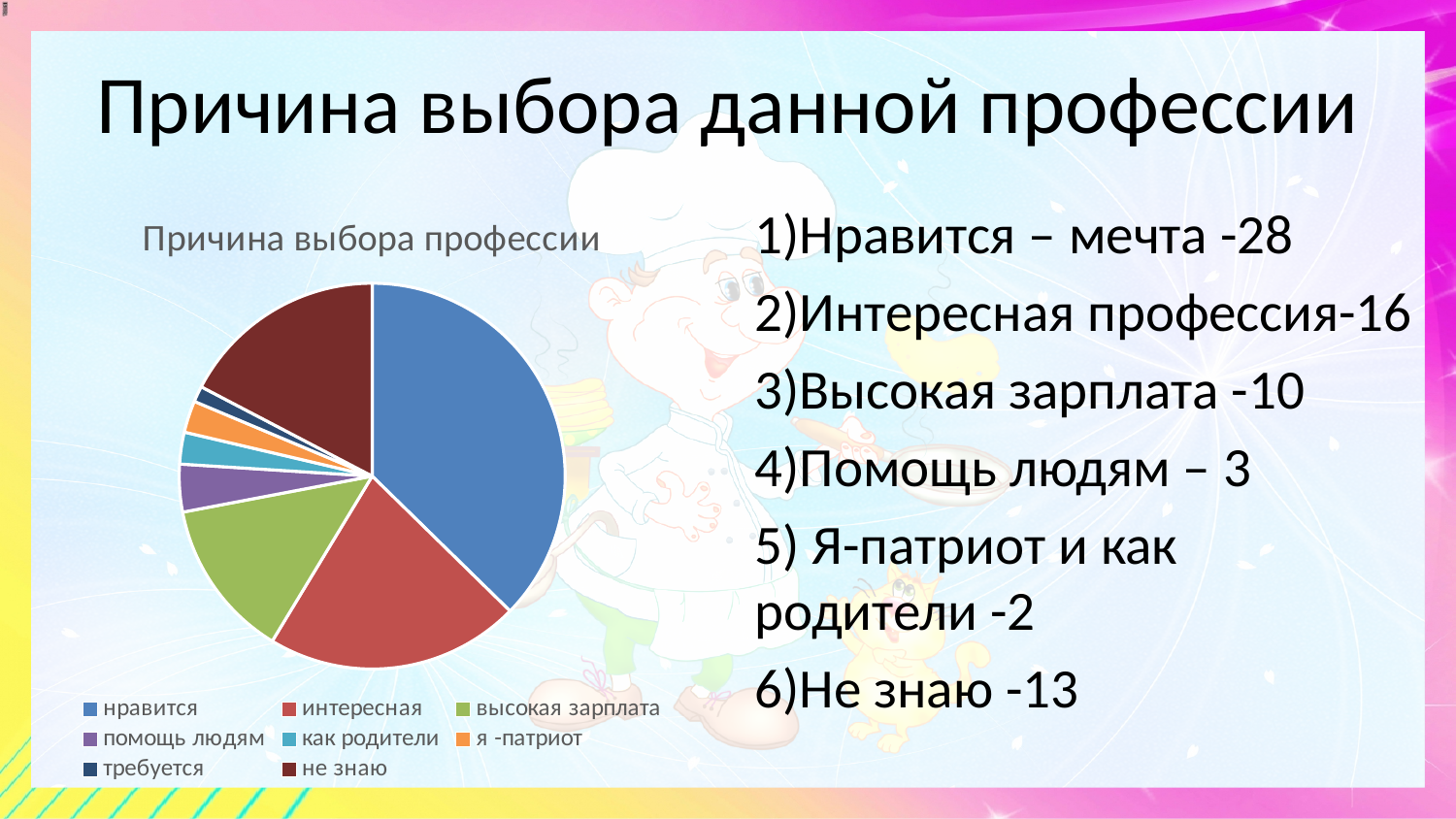
According to the slide, what is the value for "высокая зарплата"? 10 Which slice is larger: "интересная" or "помощь людям"? интересная According to the slide, what is the value for "нравится" (Нравится – мечта)? 28 What kind of chart is shown on the slide? pie chart Which category has the largest slice of the pie? нравится Which slice is larger: "не знаю" or "высокая зарплата"? не знаю Which category has the smallest slice of the pie? требуется According to the slide, what is the value for "интересная" (Интересная профессия)? 16 What is the difference between the values for "нравится" (28) and "интересная" (16)? 12 How many categories does the pie chart's legend list? 8 According to the slide, what is the value for "не знаю"? 13 What is the title of the chart? Причина выбора профессии